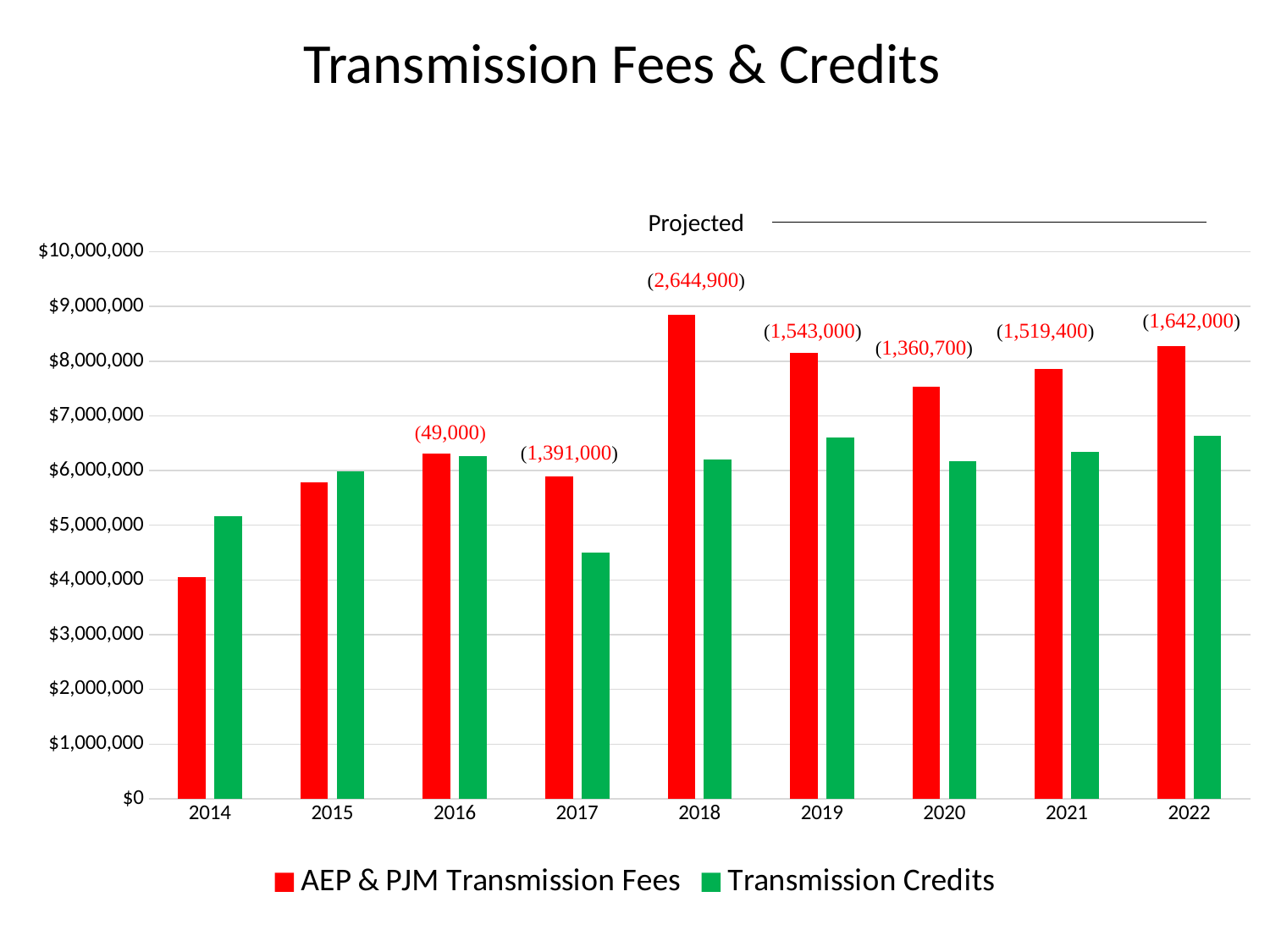
How many series does the legend list? 2 What is the title of the chart? Transmission Fees & Credits Do the AEP & PJM Transmission Fees rise or fall from 2014 to 2018? rise In which year are the AEP & PJM Transmission Fees highest? 2018 Is the value for AEP & PJM Transmission Fees in 2018 greater or less than $9,000,000? less What kind of chart is shown on the slide? bar chart In 2014, which is larger: AEP & PJM Transmission Fees or Transmission Credits? Transmission Credits In which year are the Transmission Credits lowest? 2017 In 2018, which is larger: AEP & PJM Transmission Fees or Transmission Credits? AEP & PJM Transmission Fees How many years are shown on the x axis? 9 Is the value for Transmission Credits in 2017 greater or less than $5,000,000? less In which year are the AEP & PJM Transmission Fees lowest? 2014